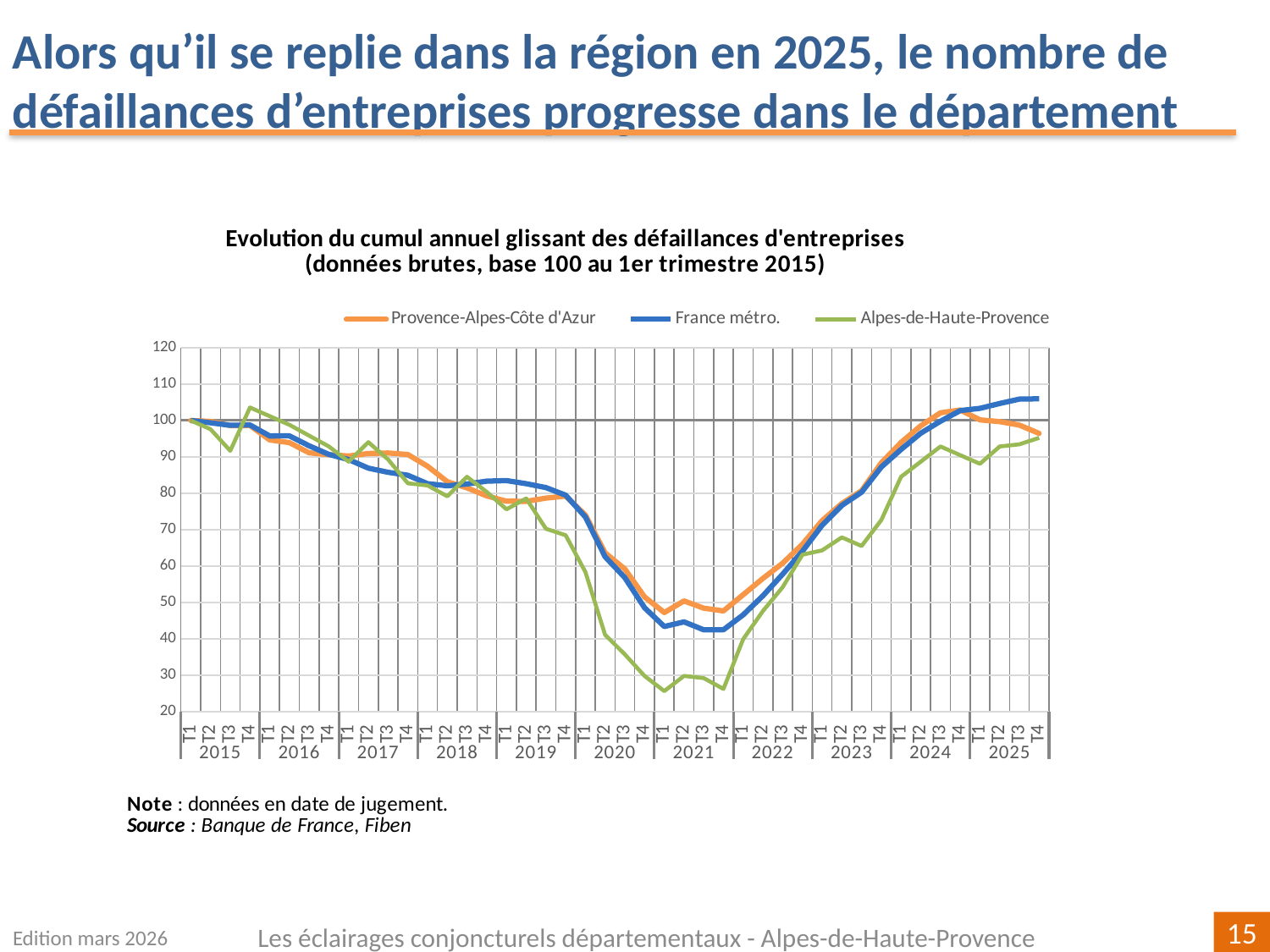
Do the values of the France métro. series rise or fall between T1 2020 and T1 2021? fall What is the title of the chart? Evolution du cumul annuel glissant des défaillances d'entreprises (données brutes, base 100 au 1er trimestre 2015) How many years are labelled on the x axis? 11 Is the value for France métro. at T4 2025 greater or less than 100? greater Is the value for Alpes-de-Haute-Provence at T1 2021 greater or less than 30? less Is the value for France métro. at T1 2021 greater or less than 50? less How many series does the legend list? 3 What kind of chart is shown on the slide? line chart At T4 2025, which series is higher: France métro. or Provence-Alpes-Côte d'Azur? France métro. Which series reaches the lowest point on the chart? Alpes-de-Haute-Provence What is the value of the France métro. series at T1 2015? 100